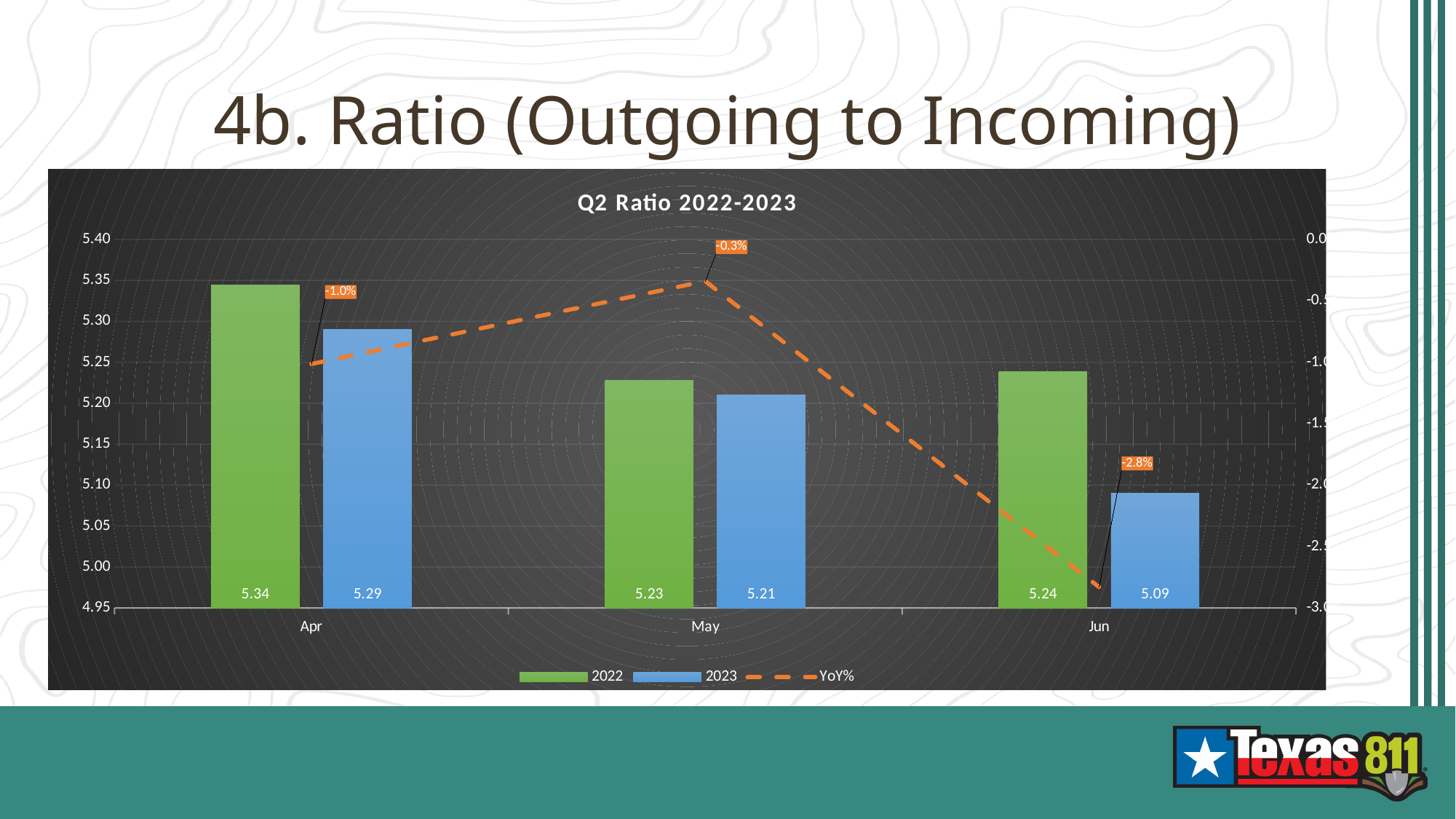
What is the title of the chart? Q2 Ratio 2022-2023 What is the 2022 ratio value for Apr? 5.34 Which month has the lowest 2023 ratio value? Jun What is the YoY% value shown for Jun? -2.8% What is the difference between the 2022 and 2023 ratio values for Jun? 0.15 How many months are shown on the x axis? 3 Do the 2023 ratio values rise or fall from Apr to Jun? fall What is the 2023 ratio value for Jun? 5.09 Which month has the highest 2022 ratio value? Apr How many series does the legend list? 3 What is the YoY% value shown for May? -0.3% Which is larger, the 2023 value for Apr or the 2023 value for May? 2023 value for Apr